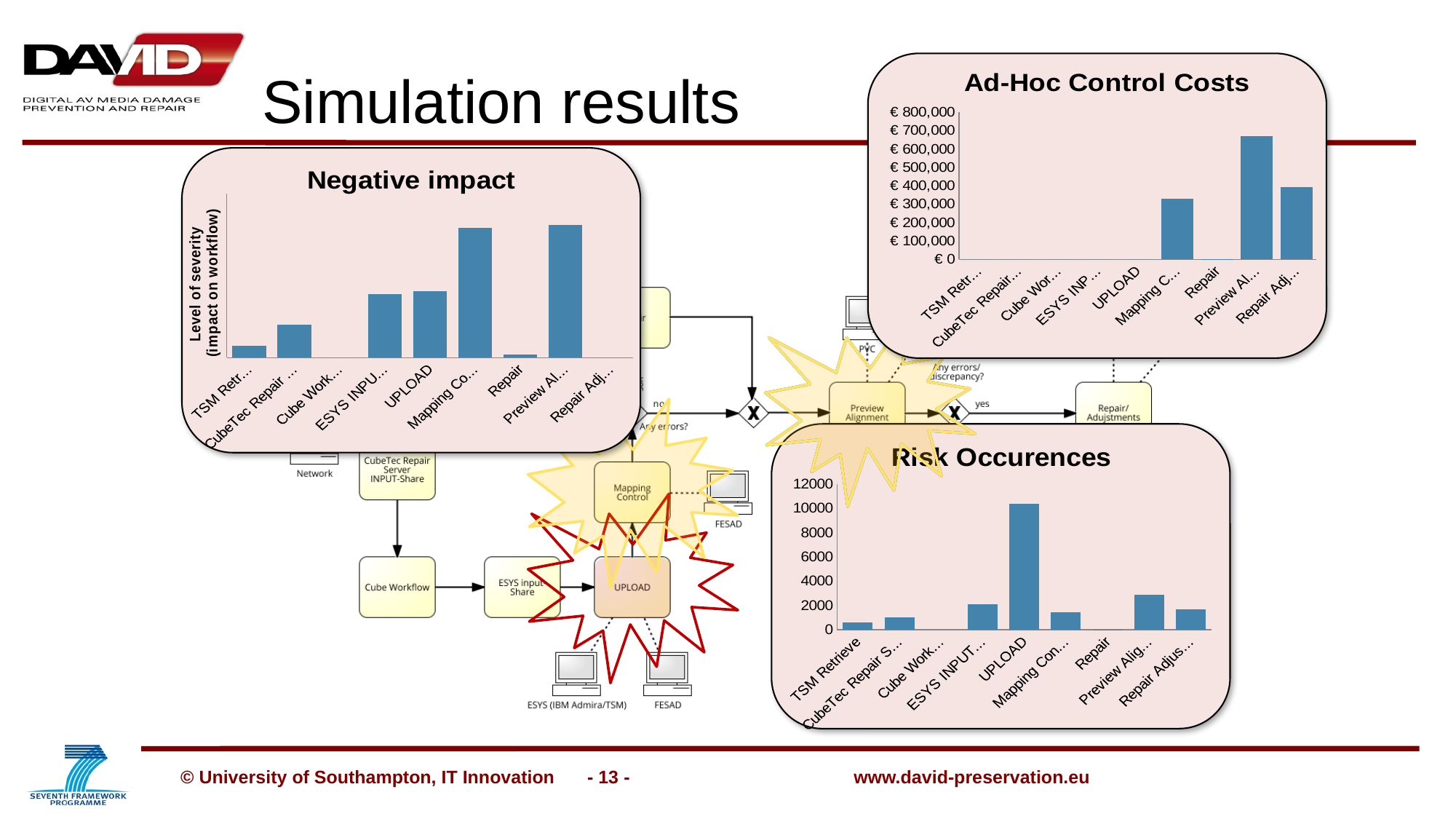
In the Risk Occurences chart, which is larger, the value for Preview Alig... or the value for Repair Adjus...? Preview Alig... In the Ad-Hoc Control Costs chart, which category has the highest cost? Preview Al... In the Risk Occurences chart, is the value for UPLOAD greater or less than 8000? greater How many categories are shown on the x axis of the Ad-Hoc Control Costs chart? 9 In the Ad-Hoc Control Costs chart, which is larger, the value for Repair Adj... or the value for Mapping C...? Repair Adj... In the Ad-Hoc Control Costs chart, is the value for Preview Al... greater or less than € 600,000? greater What is the y-axis label of the Negative impact chart? Level of severity (impact on workflow) In the Ad-Hoc Control Costs chart, is the value for Mapping C... greater or less than € 200,000? greater What kind of chart is the Ad-Hoc Control Costs chart? bar chart In the Risk Occurences chart, which category has the highest number of occurrences? UPLOAD